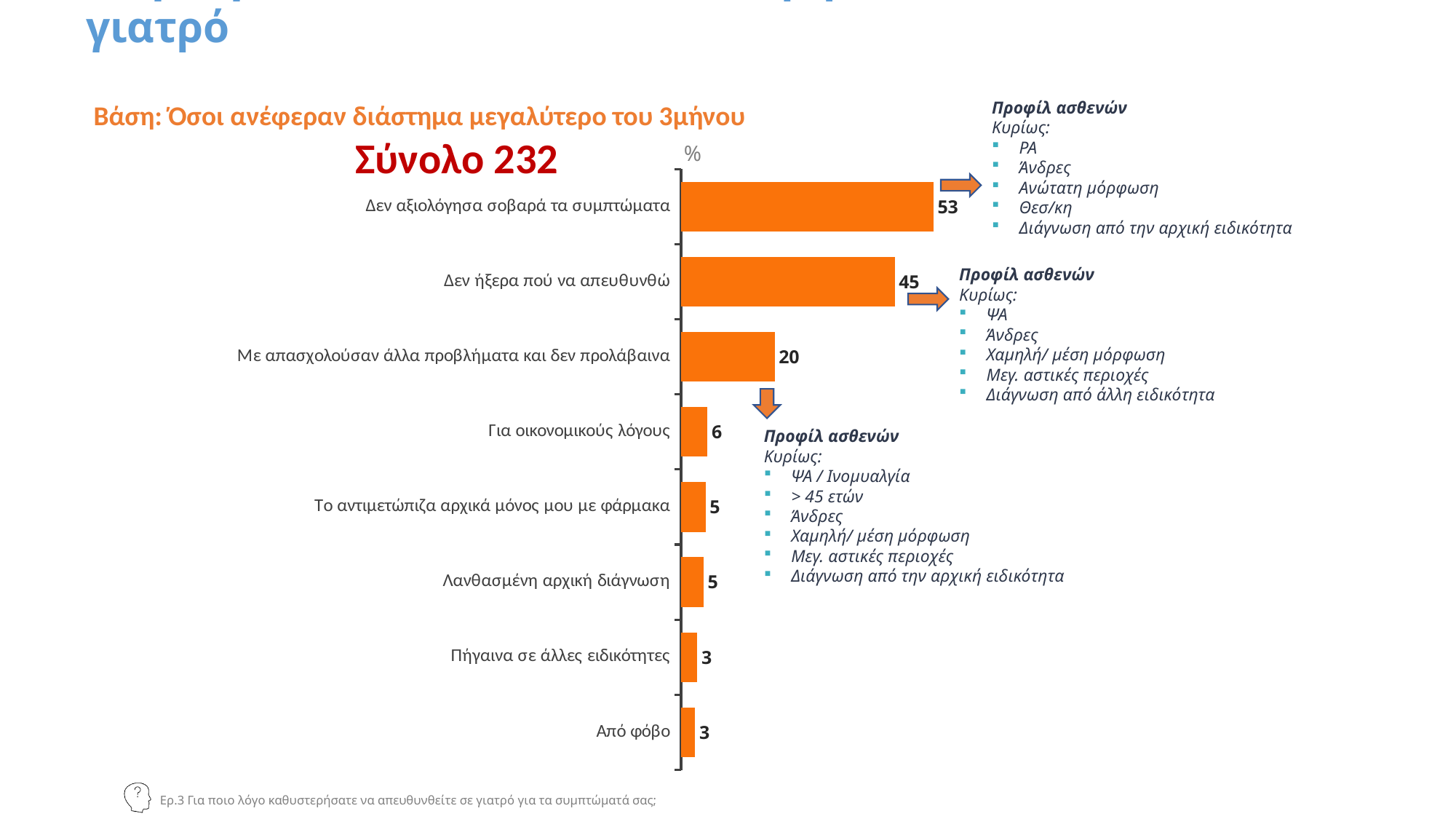
What total base (Σύνολο) is stated above the chart? 232 Which is larger, the value for "Με απασχολούσαν άλλα προβλήματα και δεν προλάβαινα" or the value for "Για οικονομικούς λόγους"? Με απασχολούσαν άλλα προβλήματα και δεν προλάβαινα What is the difference between the values for "Δεν αξιολόγησα σοβαρά τα συμπτώματα" and "Δεν ήξερα πού να απευθυνθώ"? 8 What kind of chart is shown on the slide? Bar chart Which category has the highest value? Δεν αξιολόγησα σοβαρά τα συμπτώματα How many categories are shown in the chart? 8 What is the value for "Λανθασμένη αρχική διάγνωση"? 5 What is the value for "Δεν αξιολόγησα σοβαρά τα συμπτώματα"? 53 What is the value for "Για οικονομικούς λόγους"? 6 What is the value for "Δεν ήξερα πού να απευθυνθώ"? 45 What is the difference between the values for "Δεν ήξερα πού να απευθυνθώ" and "Με απασχολούσαν άλλα προβλήματα και δεν προλάβαινα"? 25 What is the value for "Με απασχολούσαν άλλα προβλήματα και δεν προλάβαινα"? 20